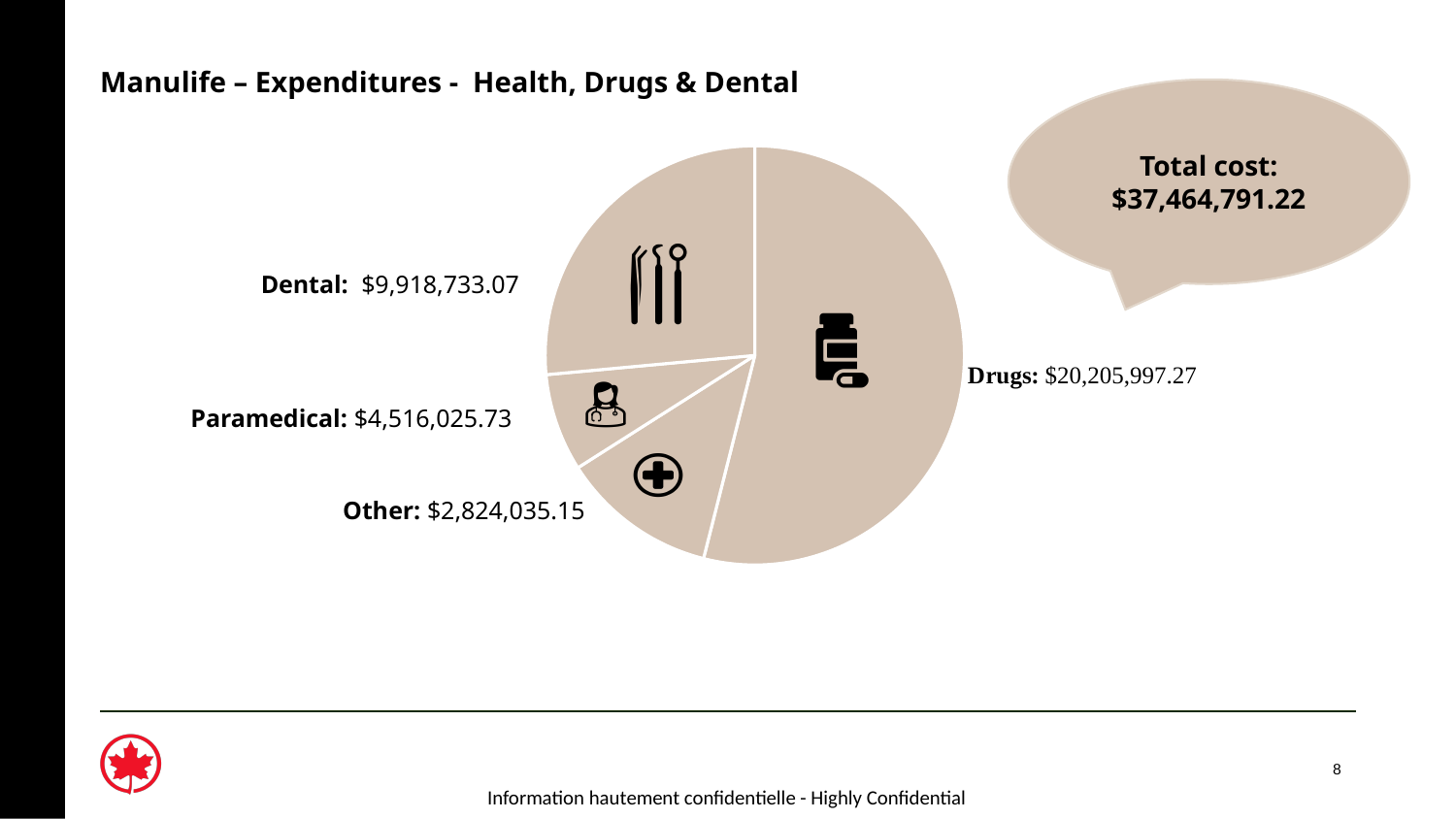
What is the total cost shown on the slide? $37,464,791.22 Which category has the smallest expenditure? Other What is the expenditure for Paramedical? $4,516,025.73 What is the expenditure for Other? $2,824,035.15 How many categories are shown in the pie chart? 4 Which category has the largest expenditure? Drugs What type of chart is shown on the slide? Pie chart What is the difference between the Drugs and Dental expenditures? $10,287,264.20 Which is larger, the Paramedical expenditure or the Other expenditure? Paramedical What is the expenditure for Dental? $9,918,733.07 What is the expenditure for Drugs? $20,205,997.27 Does the Drugs slice account for more or less than half of the pie? More